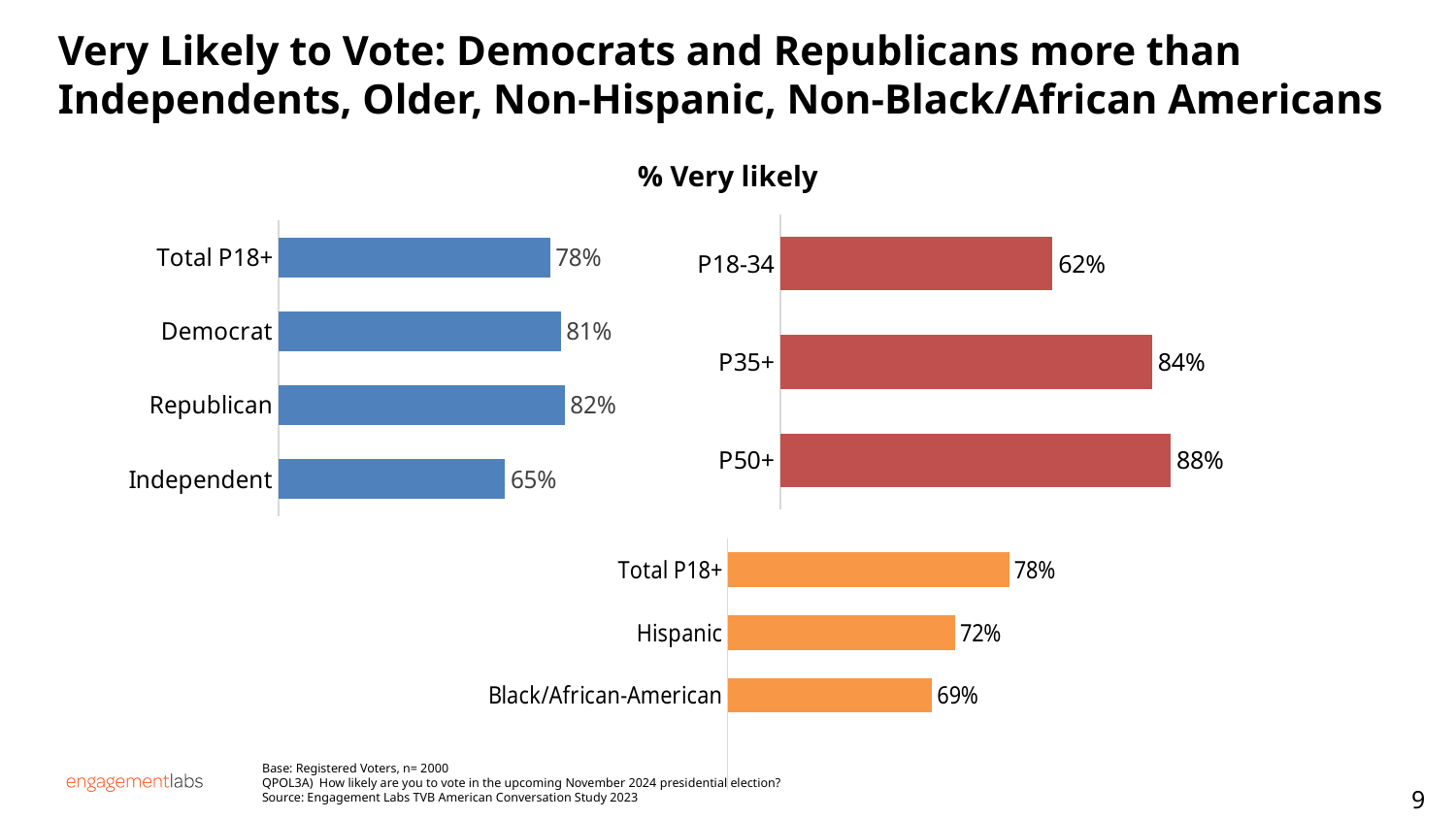
In the orange chart at the bottom (ethnicity), which category has the lowest value? Black/African-American In the red chart on the right (age groups), what is the difference between P50+ and P18-34? 26% In the blue chart on the left (party affiliation), what is the value for Democrat? 81% In the orange chart at the bottom (ethnicity), which is larger, Total P18+ or Hispanic? Total P18+ In the red chart on the right (age groups), which category has the highest value? P50+ How many categories are shown in the blue chart on the left (party affiliation)? 4 What kind of chart is the red chart on the right (age groups)? Bar chart In the blue chart on the left (party affiliation), which category has the lowest value? Independent In the red chart on the right (age groups), what is the value for P18-34? 62% What is the shared title above the charts? % Very likely In the blue chart on the left (party affiliation), what is the difference between Republican and Independent? 17% In the orange chart at the bottom (ethnicity), what is the value for Hispanic? 72%